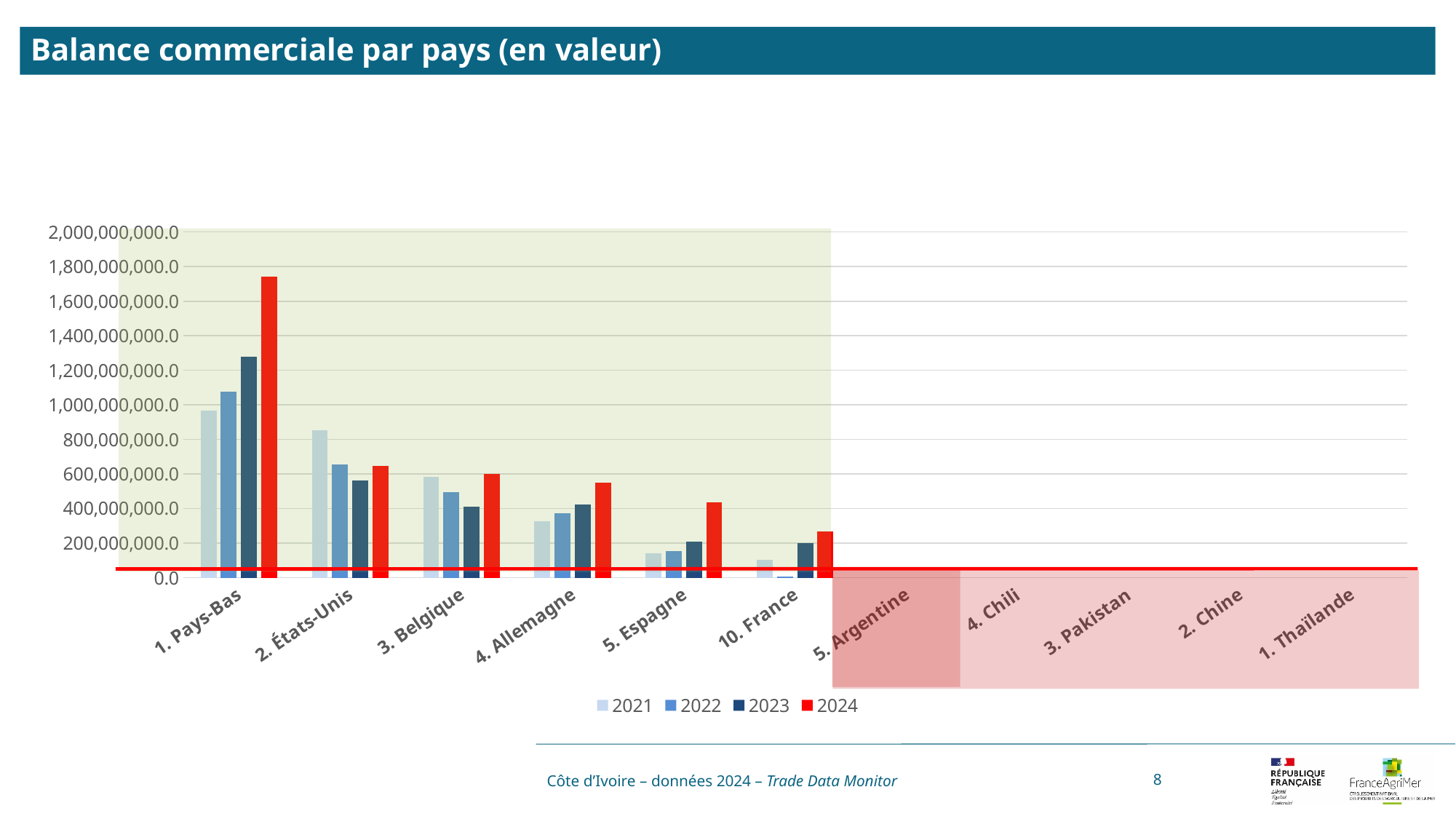
How many country categories are shown on the x axis? 11 Is the 2024 value for 10. France greater or less than 200,000,000.0? greater How many series does the legend list? 4 What is the title of the chart? Balance commerciale par pays (en valeur) Do the values for 1. Pays-Bas rise or fall from 2021 to 2024? rise Is the 2021 value for 2. États-Unis greater or less than 800,000,000.0? greater Is the 2024 value for 1. Pays-Bas greater or less than 1,600,000,000.0? greater Which is larger, the 2024 value for 1. Pays-Bas or the 2024 value for 2. États-Unis? 1. Pays-Bas What kind of chart is shown on the slide? bar chart Which country has the highest 2024 bar? 1. Pays-Bas